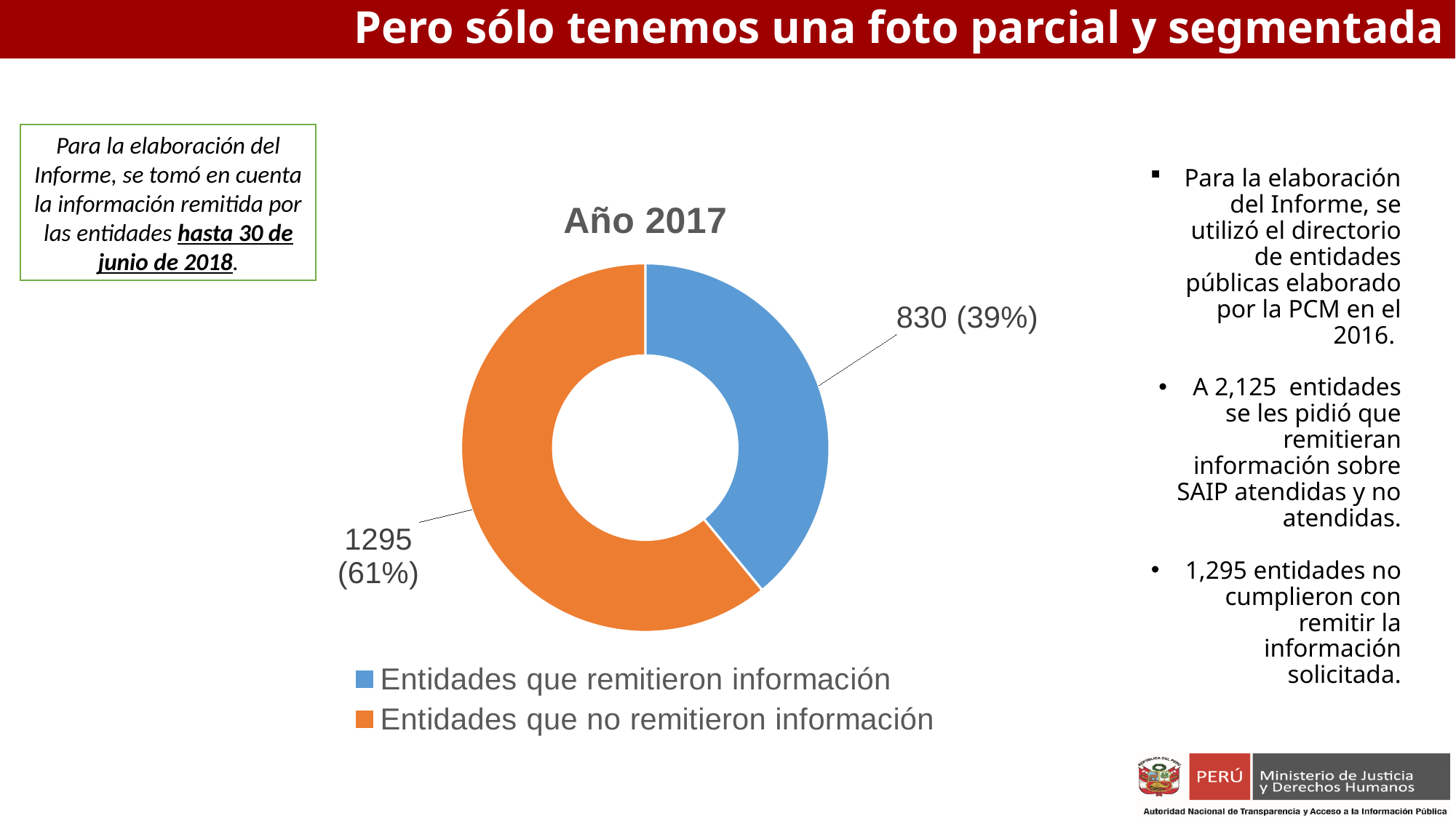
What is the difference between the number of entities that did not submit information and those that did in the Año 2017 chart? 465 What is the value for 'Entidades que no remitieron información' in the Año 2017 chart? 1295 What type of chart is shown on the slide? Doughnut chart What share of the Año 2017 chart does 'Entidades que no remitieron información' represent? 61% Which is larger in the Año 2017 chart: 'Entidades que remitieron información' or 'Entidades que no remitieron información'? Entidades que no remitieron información What is the total of the two values shown in the Año 2017 chart? 2125 Which category has the smallest slice in the Año 2017 chart? Entidades que remitieron información What is the title of the chart on the slide? Año 2017 What is the value for 'Entidades que remitieron información' in the Año 2017 chart? 830 How many categories are shown in the Año 2017 chart? 2 Which category has the largest slice in the Año 2017 chart? Entidades que no remitieron información What share of the Año 2017 chart does 'Entidades que remitieron información' represent? 39%